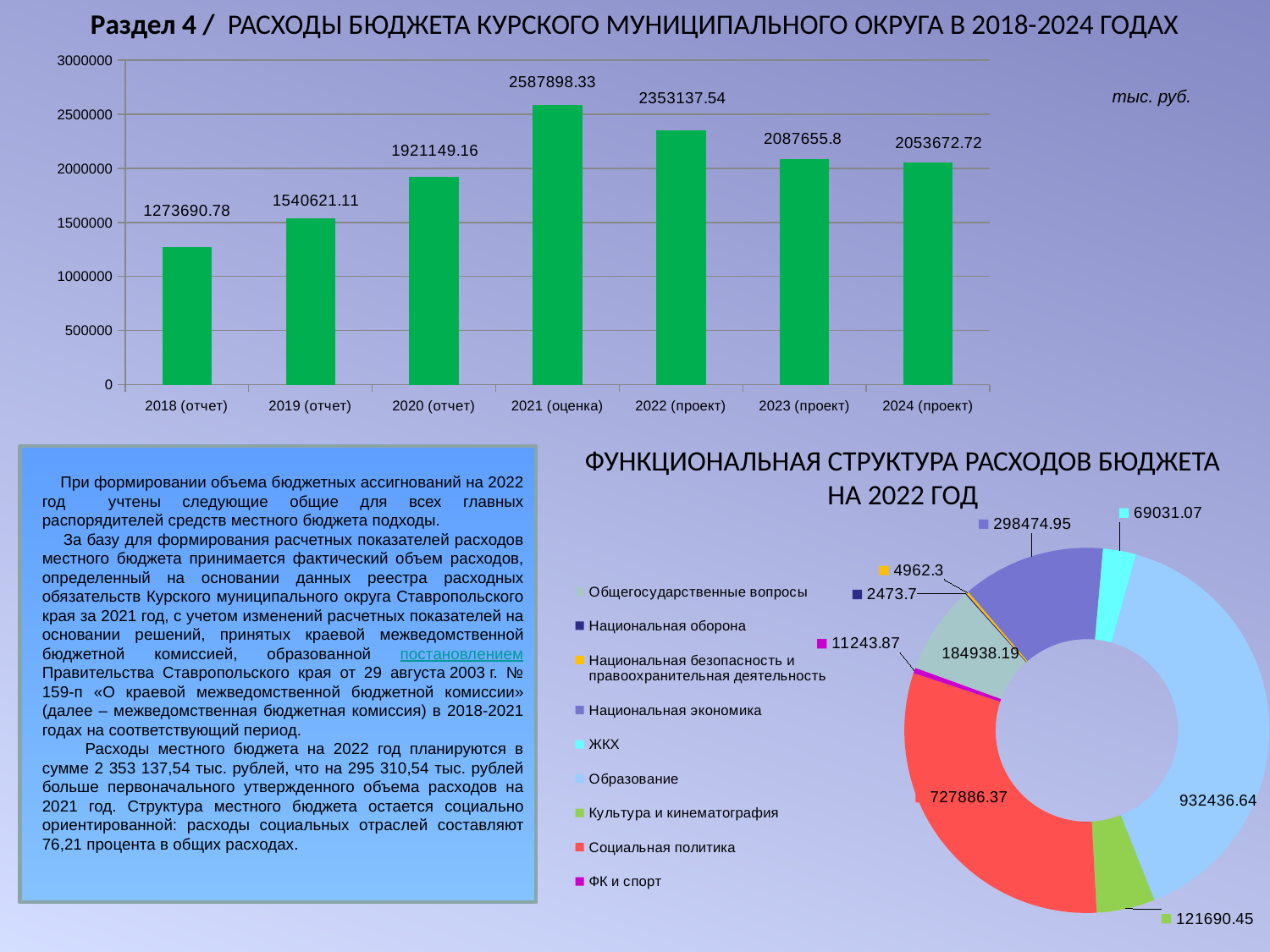
In the top bar chart, which is larger: the value for 2023 (проект) or 2024 (проект)? 2023 (проект) What kind of chart is the chart titled 'ФУНКЦИОНАЛЬНАЯ СТРУКТУРА РАСХОДОВ БЮДЖЕТА НА 2022 ГОД'? doughnut chart How many categories does the legend of the chart 'ФУНКЦИОНАЛЬНАЯ СТРУКТУРА РАСХОДОВ БЮДЖЕТА НА 2022 ГОД' list? 9 In the top bar chart, what is the value for 2018 (отчет)? 1273690.78 In the chart 'ФУНКЦИОНАЛЬНАЯ СТРУКТУРА РАСХОДОВ БЮДЖЕТА НА 2022 ГОД', what is the value for Образование? 932436.64 In the top bar chart, which year has the highest value? 2021 (оценка) In the top bar chart, what is the value for 2021 (оценка)? 2587898.33 In the top bar chart, which year has the lowest value? 2018 (отчет) In the top bar chart, do the values rise or fall from 2018 (отчет) to 2021 (оценка)? rise In the top bar chart, what is the difference between the values for 2021 (оценка) and 2018 (отчет)? 1314207.55 In the chart 'ФУНКЦИОНАЛЬНАЯ СТРУКТУРА РАСХОДОВ БЮДЖЕТА НА 2022 ГОД', which category has the smallest value? Национальная оборона In the top bar chart, how many years (bars) are shown? 7